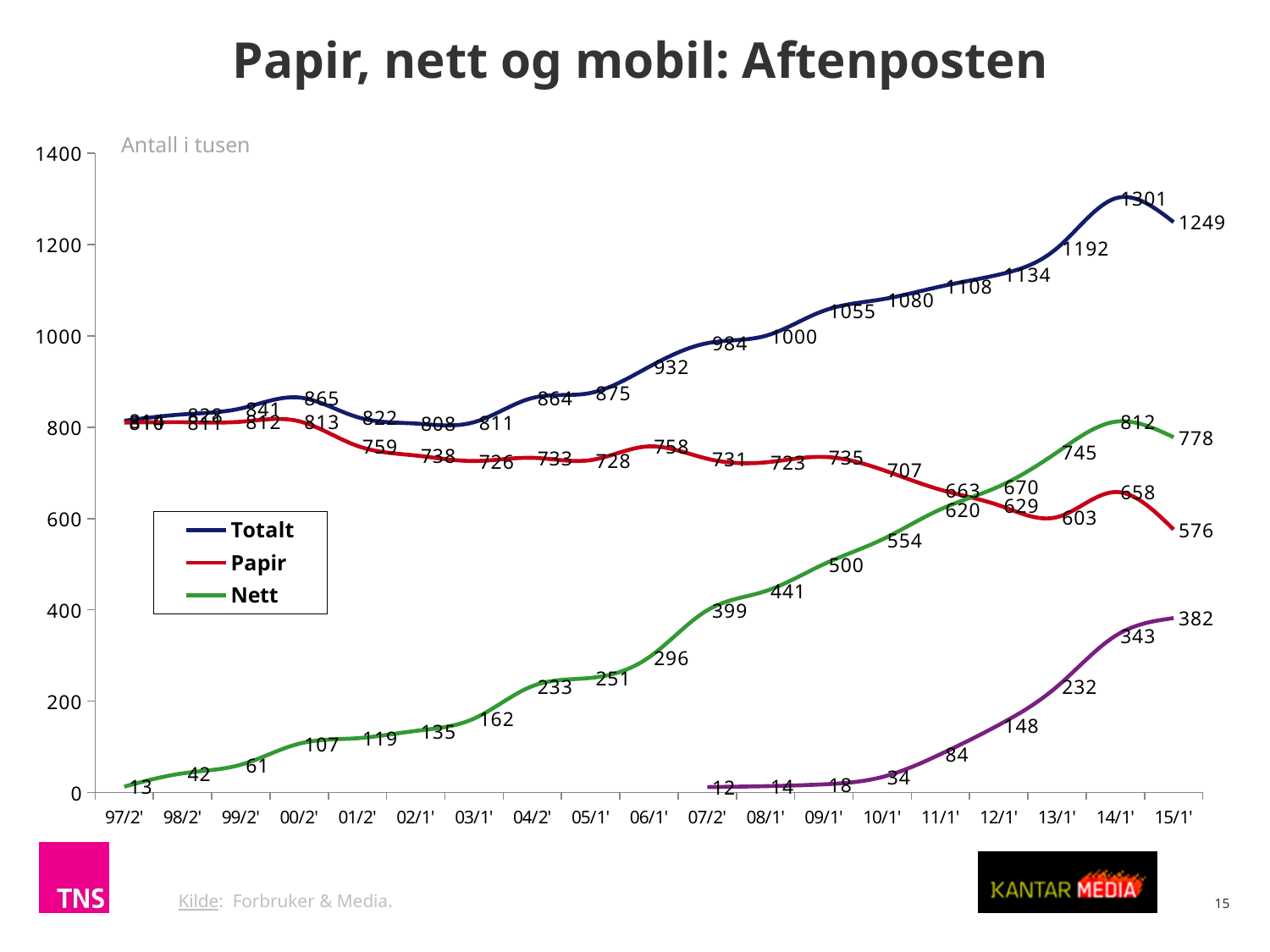
How many points are labelled on the x axis? 19 At which point on the x axis does Totalt reach its highest value? 14/1' At which point on the x axis is Papir at its lowest value? 15/1' Does the Nett series rise or fall from 97/2' to 14/1'? rise What is the value of Totalt at 14/1'? 1301 What is the value of Papir at 15/1'? 576 What is the value of the purple line at 15/1'? 382 What kind of chart is shown on the slide? line chart Which is larger at 15/1', Nett or Papir? Nett What is the value of Nett at 10/1'? 554 How many series does the legend list? 3 What is the difference between Totalt and Papir at 15/1'? 673